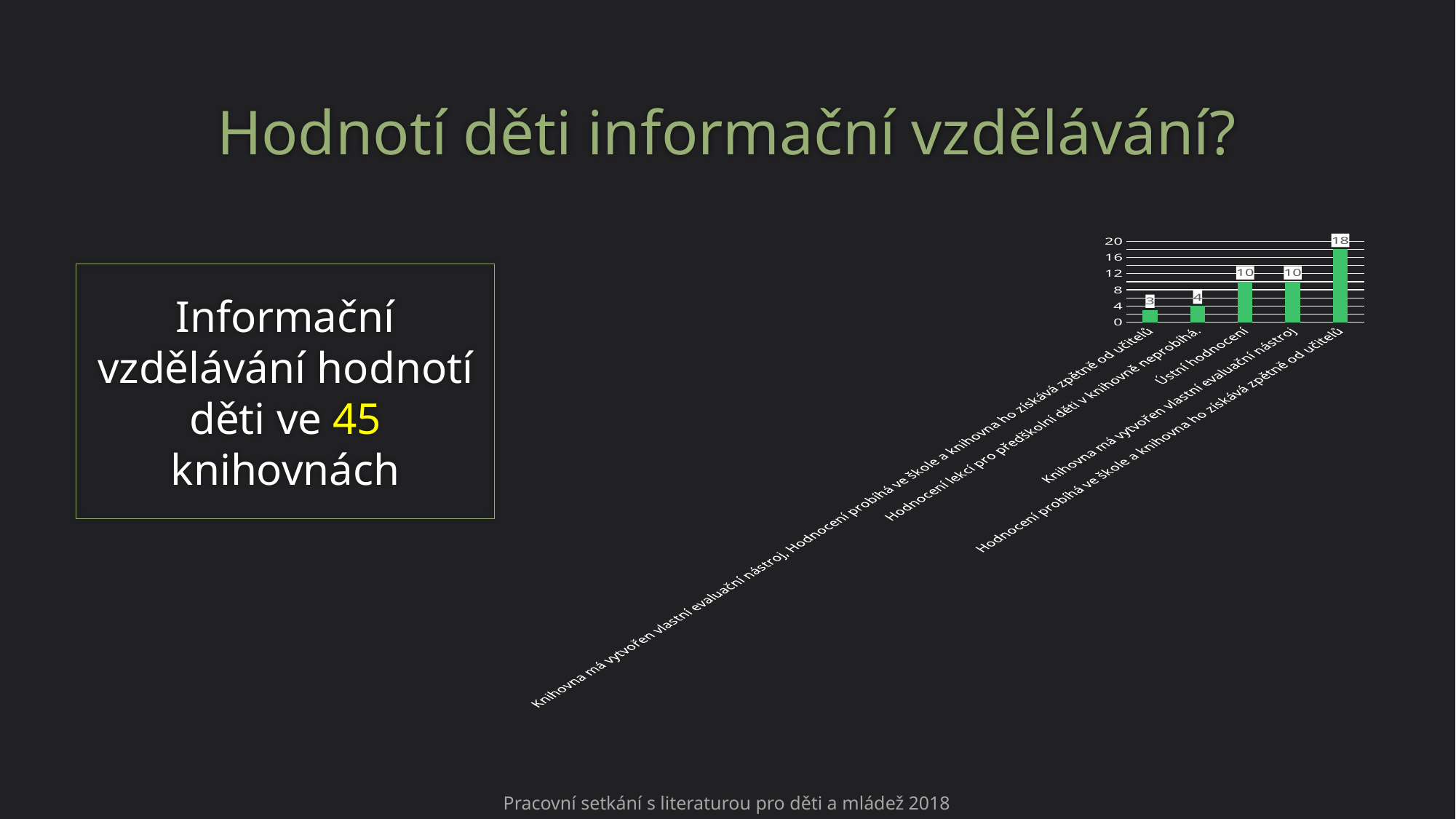
How many categories are shown in the chart? 5 Is the value for "Hodnocení probíhá ve škole a knihovna ho získává zpětně od učitelů" greater or less than 16? greater Which category has the lowest value? Knihovna má vytvořen vlastní evaluační nástroj, Hodnocení probíhá ve škole a knihovna ho získává zpětně od učitelů What kind of chart is shown on the slide? bar chart What is the value for "Hodnocení lekcí pro předškolní děti v knihovně neprobíhá."? 4 Which category has the highest value? Hodnocení probíhá ve škole a knihovna ho získává zpětně od učitelů What is the value for "Hodnocení probíhá ve škole a knihovna ho získává zpětně od učitelů"? 18 What is the value for "Knihovna má vytvořen vlastní evaluační nástroj"? 10 What is the difference between the value for "Hodnocení probíhá ve škole a knihovna ho získává zpětně od učitelů" and the value for "Ústní hodnocení"? 8 What is the highest value shown on the vertical axis of the chart? 20 What is the value for "Ústní hodnocení"? 10 Which is larger: the value for "Ústní hodnocení" or the value for "Hodnocení lekcí pro předškolní děti v knihovně neprobíhá."? Ústní hodnocení